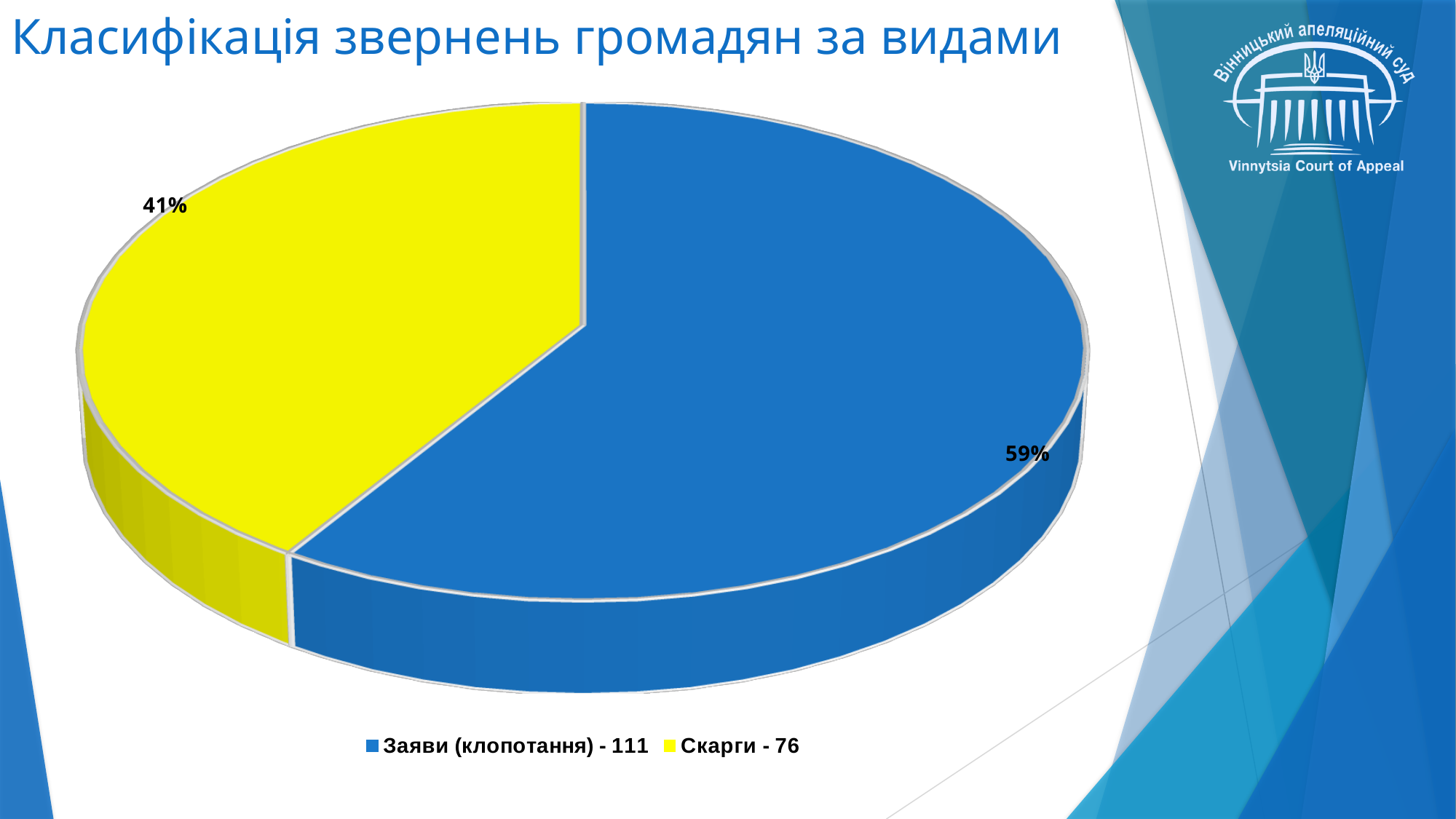
Which category has the largest slice of the pie? Заяви (клопотання) What share of the pie does the slice for Скарги represent? 41% What colour is the slice for Скарги? Yellow What share of the pie does the slice for Заяви (клопотання) represent? 59% What kind of chart is shown on the slide? Pie chart What is the title of the chart? Класифікація звернень громадян за видами Which category has the smallest slice of the pie? Скарги What count is shown in the legend for Заяви (клопотання)? 111 What is the difference in percentage points between the Заяви (клопотання) slice and the Скарги slice? 18 How many slices does the pie chart have? 2 What count is shown in the legend for Скарги? 76 Which is larger, the slice for Заяви (клопотання) or the slice for Скарги? Заяви (клопотання)